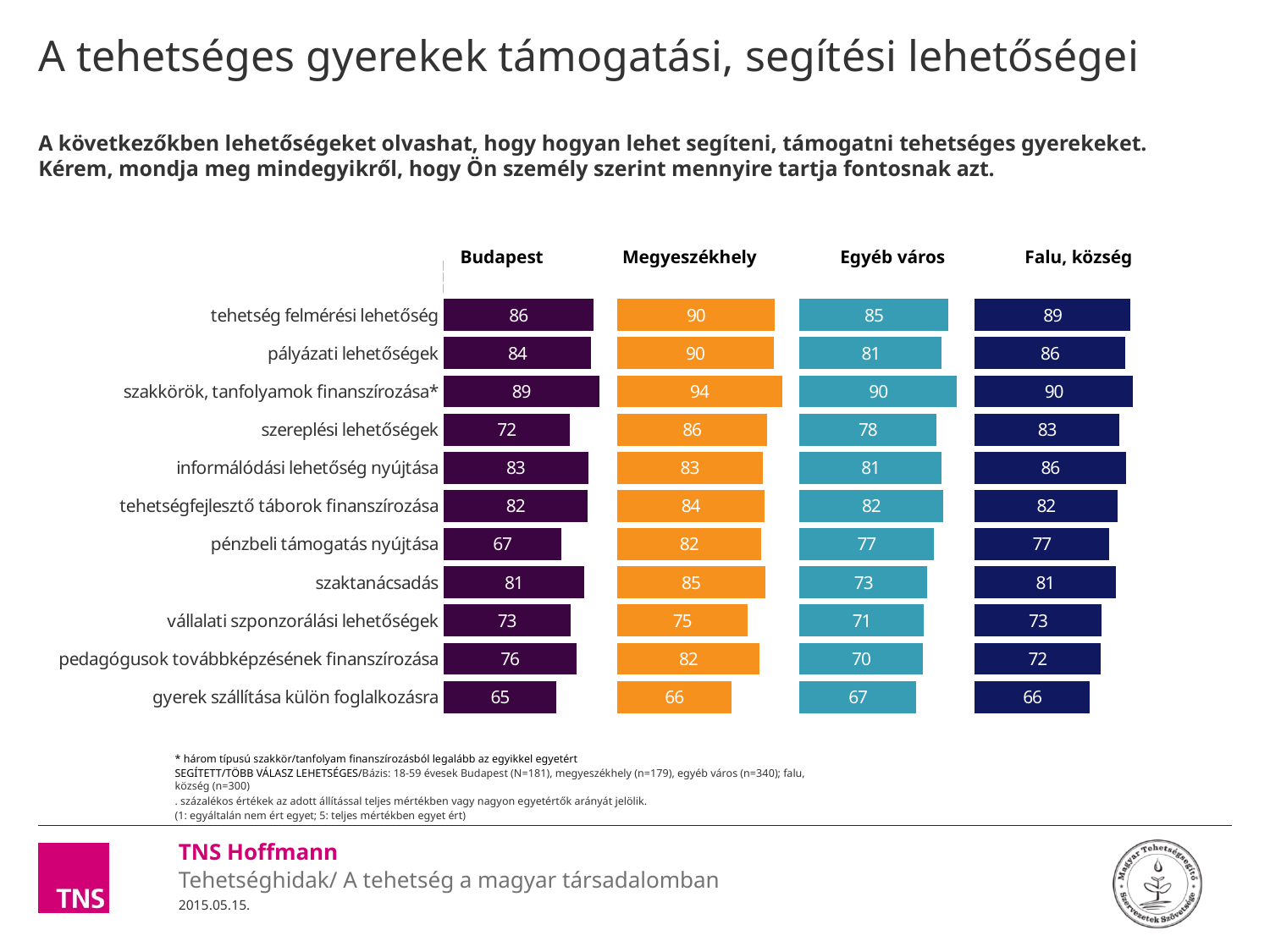
In the Egyéb város chart, what is the value for szaktanácsadás? 73 What type of chart is used for the Megyeszékhely data? bar chart In the Budapest chart, what is the value for pénzbeli támogatás nyújtása? 67 In the Falu, község chart, what is the value for pedagógusok továbbképzésének finanszírozása? 72 In the Budapest chart, what is the difference between the values for tehetség felmérési lehetőség and szereplési lehetőségek? 14 In the Megyeszékhely chart, which category has the highest value? szakkörök, tanfolyamok finanszírozása* In the Egyéb város chart, which category has the highest value? szakkörök, tanfolyamok finanszírozása* In the Falu, község chart, which is larger: the value for pályázati lehetőségek or the value for szaktanácsadás? pályázati lehetőségek In the Megyeszékhely chart, what is the value for szereplési lehetőségek? 86 How many categories are shown in the Budapest chart? 11 How many separate charts (settlement types) are shown on the slide? 4 In the Budapest chart, which category has the lowest value? gyerek szállítása külön foglalkozásra